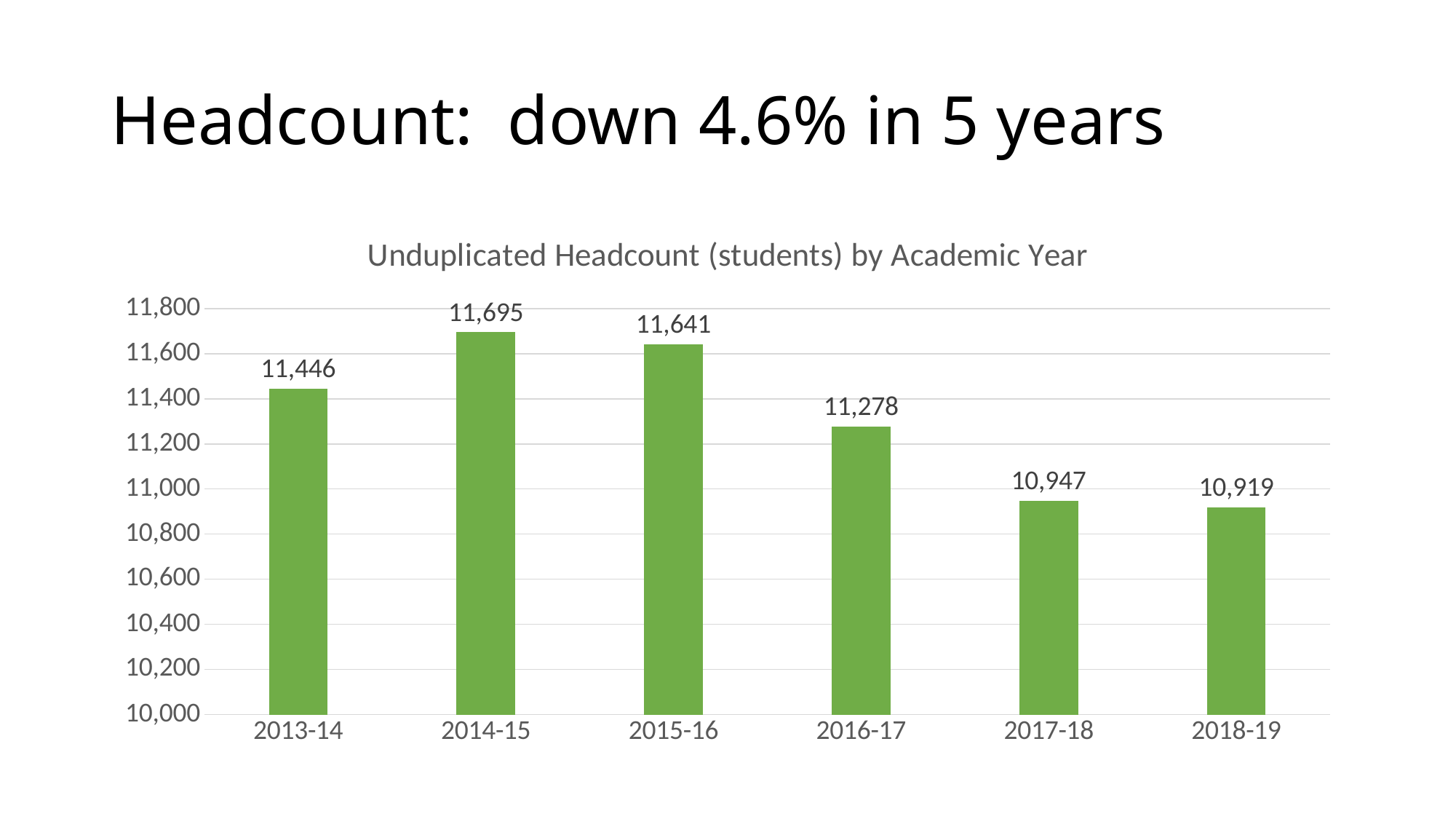
What is the unduplicated headcount for 2018-19? 10,919 What is the difference in headcount between 2014-15 and 2018-19? 776 What is the unduplicated headcount for 2013-14? 11,446 Which academic year has the lowest headcount? 2018-19 What is the difference in headcount between 2015-16 and 2016-17? 363 How many academic years are shown in the chart? 6 What kind of chart is shown on the slide? bar chart Is the headcount for 2017-18 greater or less than 11,000? less Which year has a larger headcount, 2013-14 or 2015-16? 2015-16 Which academic year has the highest headcount? 2014-15 What is the unduplicated headcount for 2016-17? 11,278 What is the title of the chart? Unduplicated Headcount (students) by Academic Year